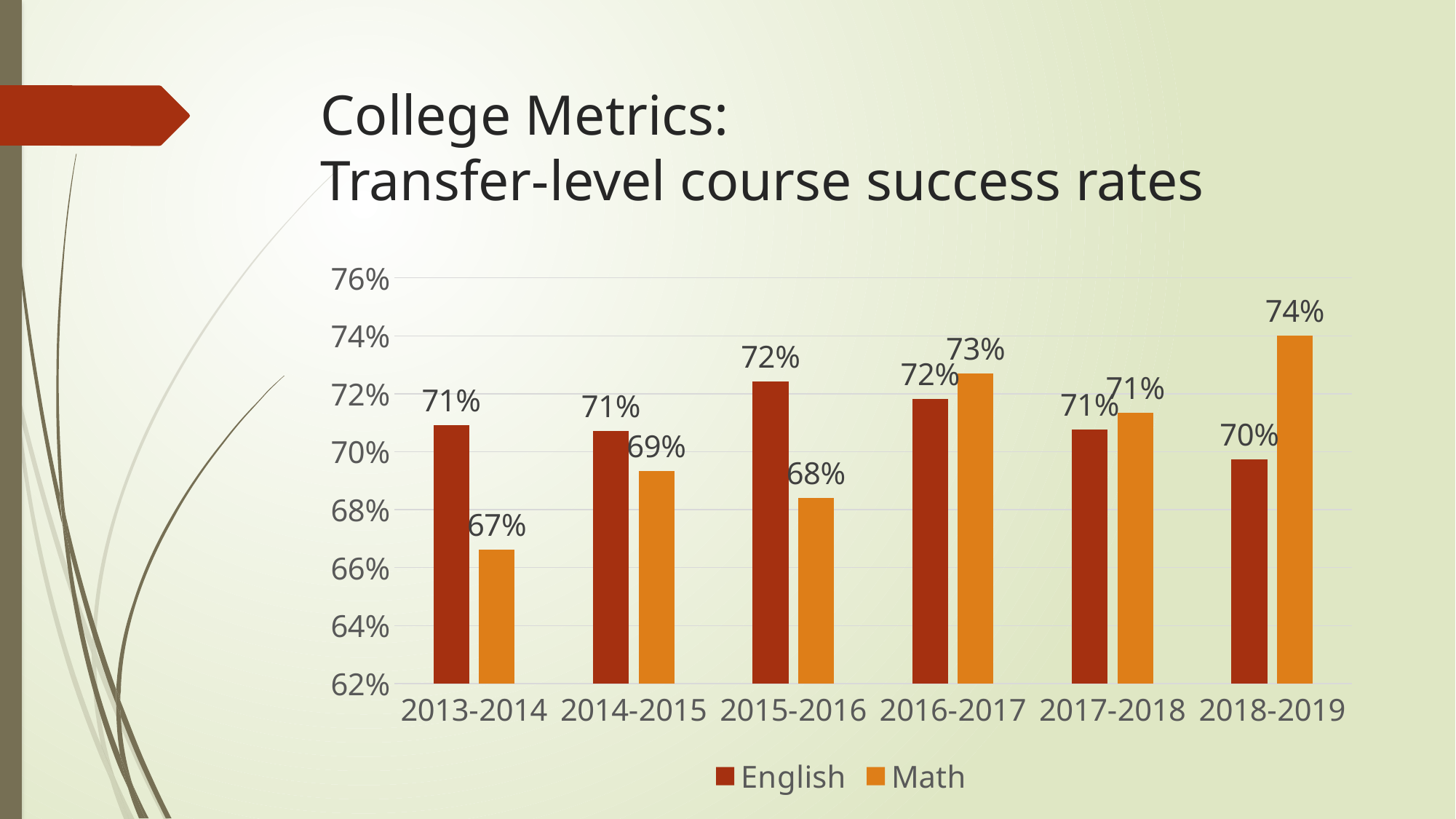
How many academic years are shown on the x axis? 6 In which year is the English success rate lowest? 2018-2019 What is the Math success rate for 2015-2016? 68% What is the English success rate for 2013-2014? 71% In 2018-2019, which is larger, the English or the Math success rate? Math What kind of chart is shown on the slide? bar chart What is the Math success rate for 2018-2019? 74% What is the difference between the English and Math success rates in 2013-2014, based on the data labels? 4% Is the Math success rate for 2013-2014 greater or less than 68%? less How many series does the legend list? 2 In which year is the Math success rate highest? 2018-2019 In which year is the Math success rate lowest? 2013-2014